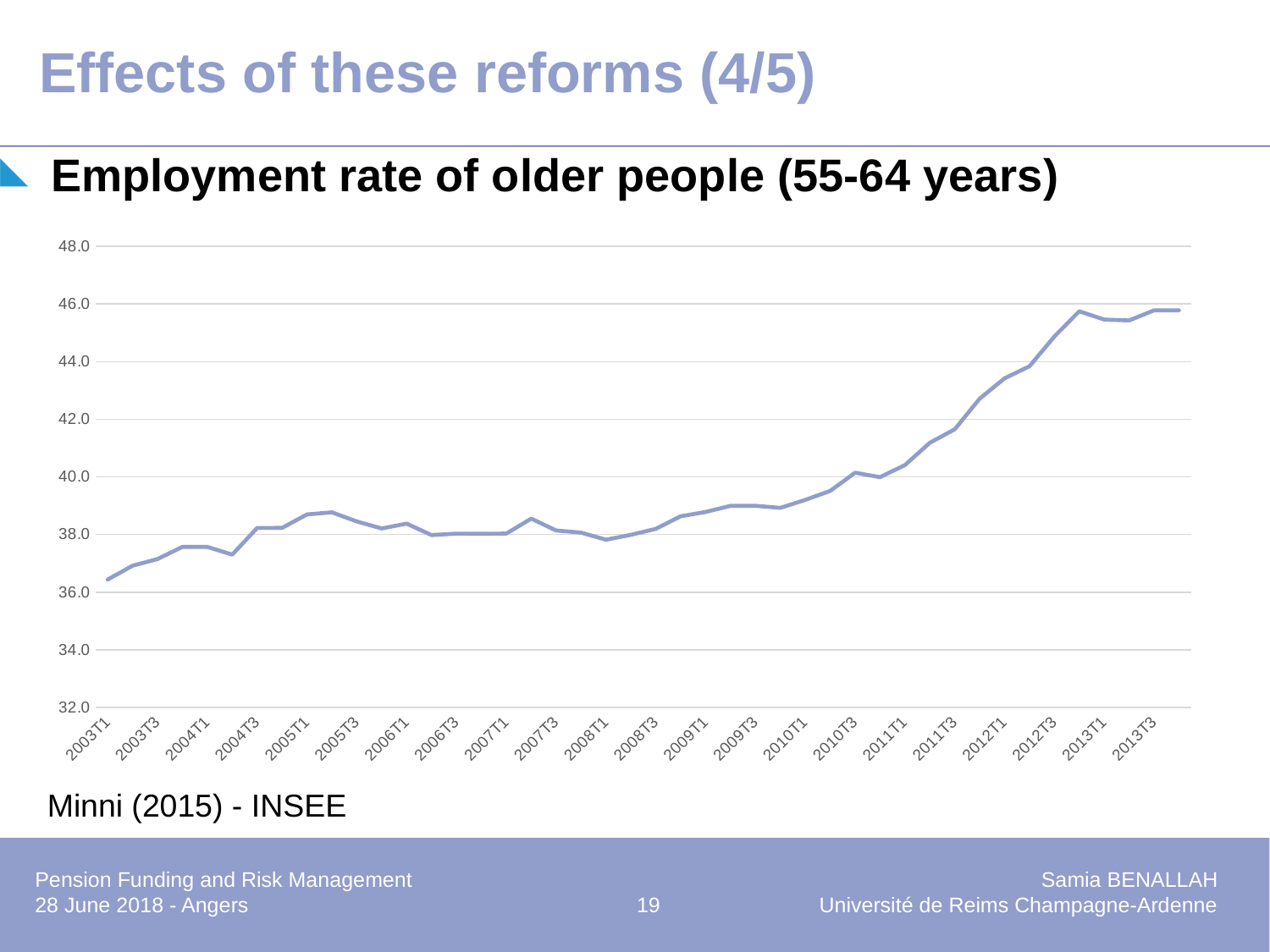
Is the value for 2011T3 greater or less than 40.0? greater What kind of chart is shown on the slide? line chart Is the value for 2008T1 greater or less than 40.0? less Which has the higher employment rate, 2003T1 or 2013T1? 2013T1 Which labelled quarter has the lowest employment rate? 2003T1 What source is cited below the chart? Minni (2015) - INSEE Which has the higher employment rate, 2005T1 or 2008T1? 2005T1 Is the value for 2003T1 greater or less than 38.0? less How many quarter labels are shown on the x axis? 22 Overall, does the employment rate rise or fall from 2003T1 to 2013T3? rise